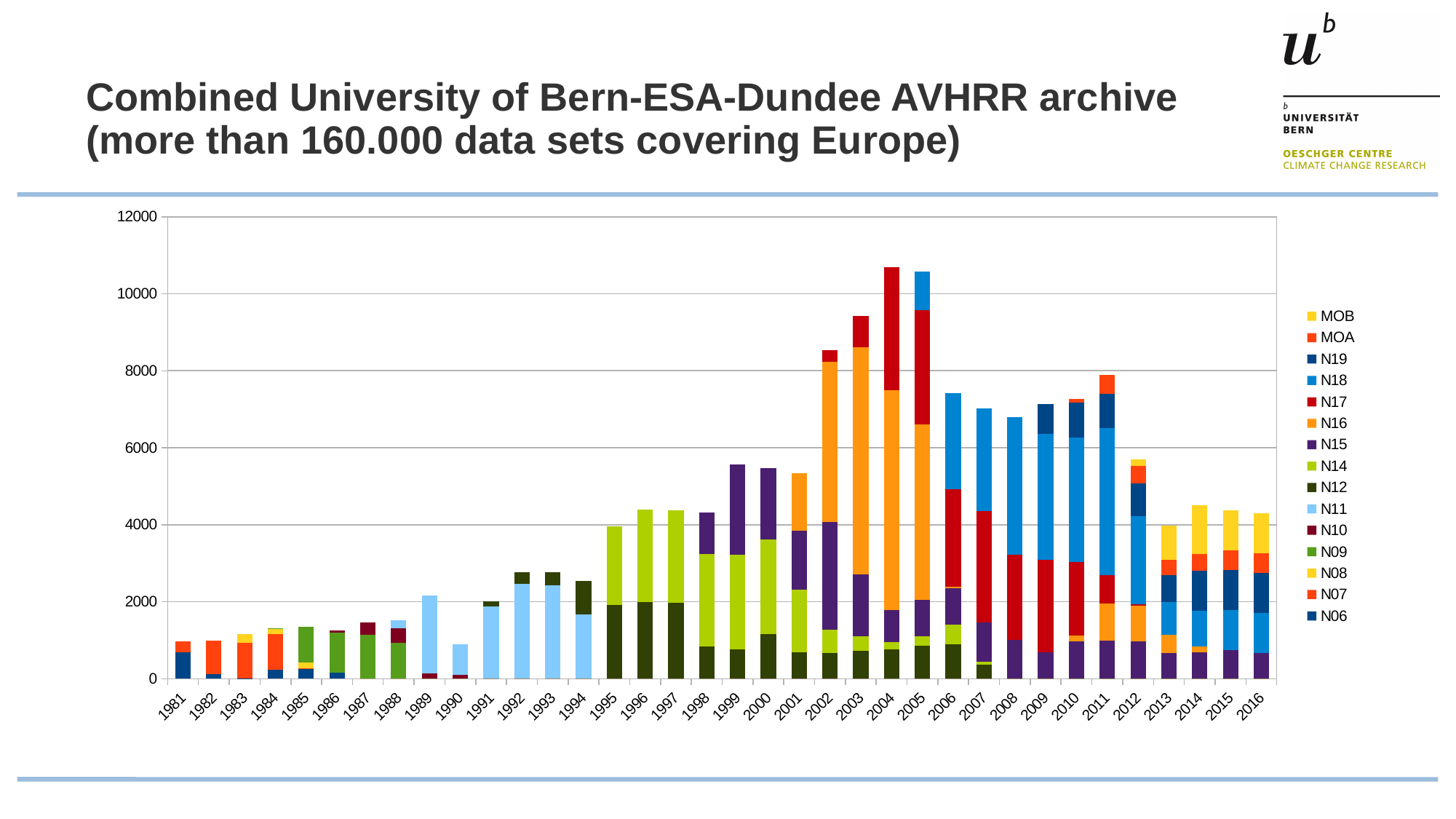
Is the total value for 2008 greater or less than 8000? less Is the total value for 2002 greater or less than 8000? greater How many years (categories) are shown along the x axis? 36 Is the total value for 2006 greater or less than 6000? greater What kind of chart is shown on the slide? stacked bar chart Do the total bar heights rise or fall from 2005 to 2008? fall Which year has the highest total bar? 2004 Which series is listed first (at the top) in the legend? MOB How many series does the legend list? 15